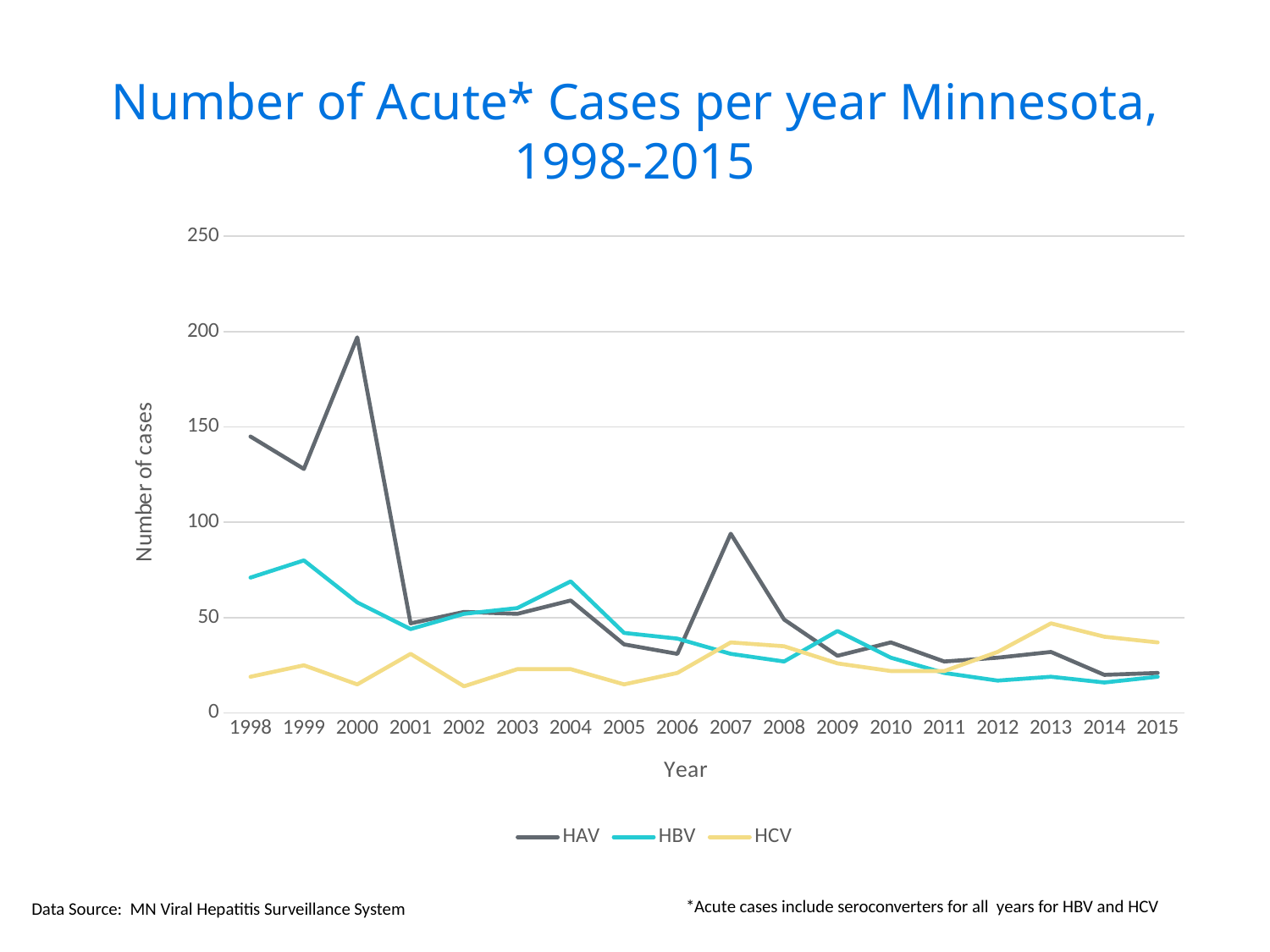
Is the HBV value for 2015 greater or less than 50? less Does the HAV series rise or fall from 2007 to 2011? fall In which year does the HBV series reach its highest value? 1999 How many years are plotted along the x axis? 18 In which year does the HAV series reach its highest value? 2000 What kind of chart is shown on the slide? line chart In 2013, which series has the larger value, HCV or HAV? HCV In 1998, which series has the larger value, HAV or HBV? HAV Is the HAV value for 2007 greater or less than 50? greater Is the HAV value for 2000 greater or less than 150? greater In which year does the HCV series reach its highest value? 2013 How many series does the legend list? 3